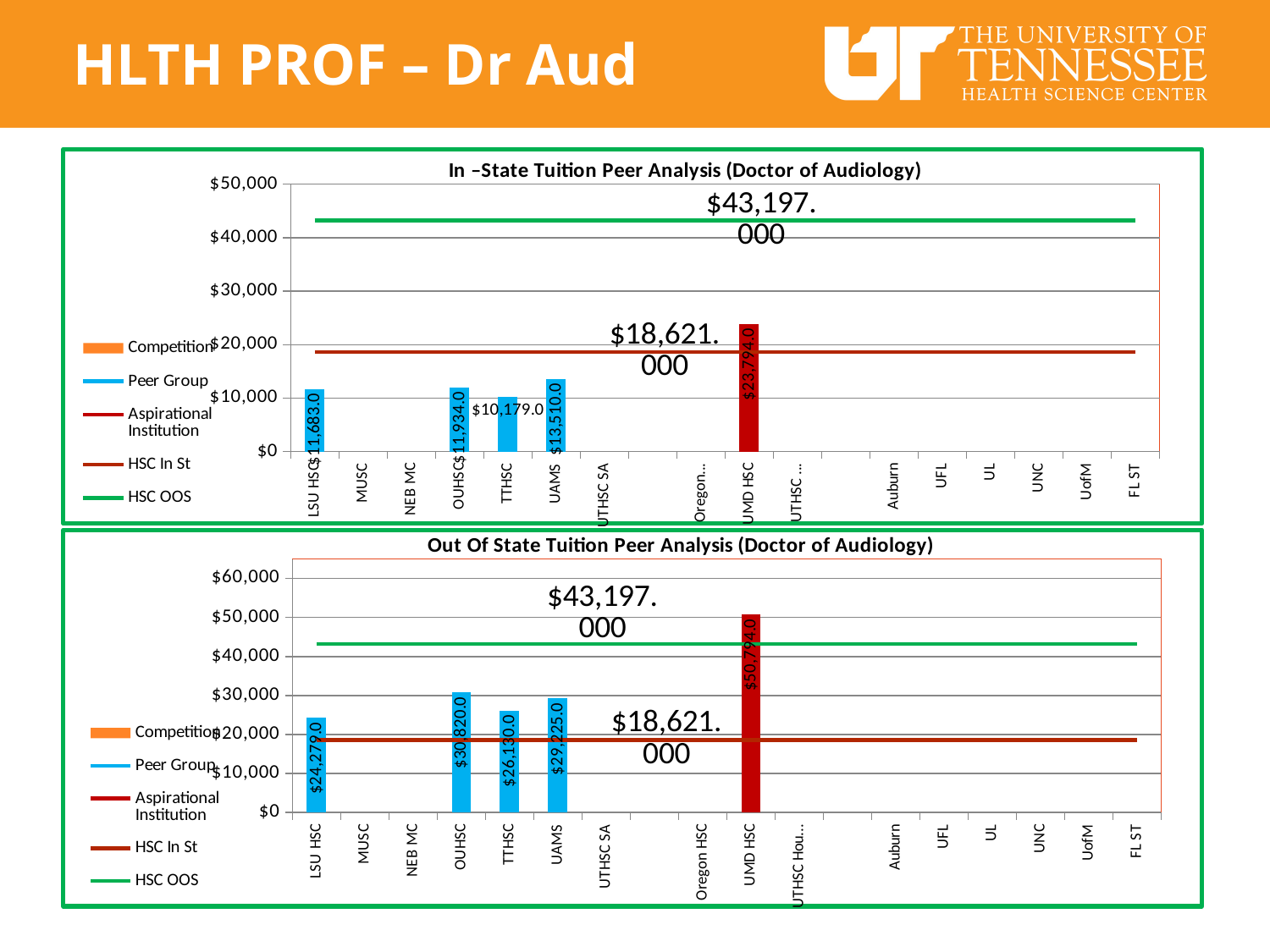
In the In-State Tuition Peer Analysis chart, which institution has the highest bar? UMD HSC In the Out Of State Tuition Peer Analysis chart, which institution has the lowest labeled bar? LSU HSC In the In-State Tuition Peer Analysis chart, what is the value for UMD HSC? $23,794.0 In the In-State Tuition Peer Analysis chart, what is the difference between the UAMS value and the TTHSC value? $3,331.0 How many entries does the legend of the In-State Tuition Peer Analysis chart list? 5 In the Out Of State Tuition Peer Analysis chart, what is the difference between the UMD HSC value and the LSU HSC value? $26,515.0 In the In-State Tuition Peer Analysis chart, which is larger, the value for OUHSC or the value for LSU HSC? OUHSC In the In-State Tuition Peer Analysis chart, which institution has the lowest labeled bar? TTHSC In the Out Of State Tuition Peer Analysis chart, how many bars have data labels? 5 In the Out Of State Tuition Peer Analysis chart, is the value for UMD HSC greater or less than $40,000? greater What type of chart is the Out Of State Tuition Peer Analysis chart? Bar chart In the Out Of State Tuition Peer Analysis chart, what is the value for OUHSC? $30,820.0